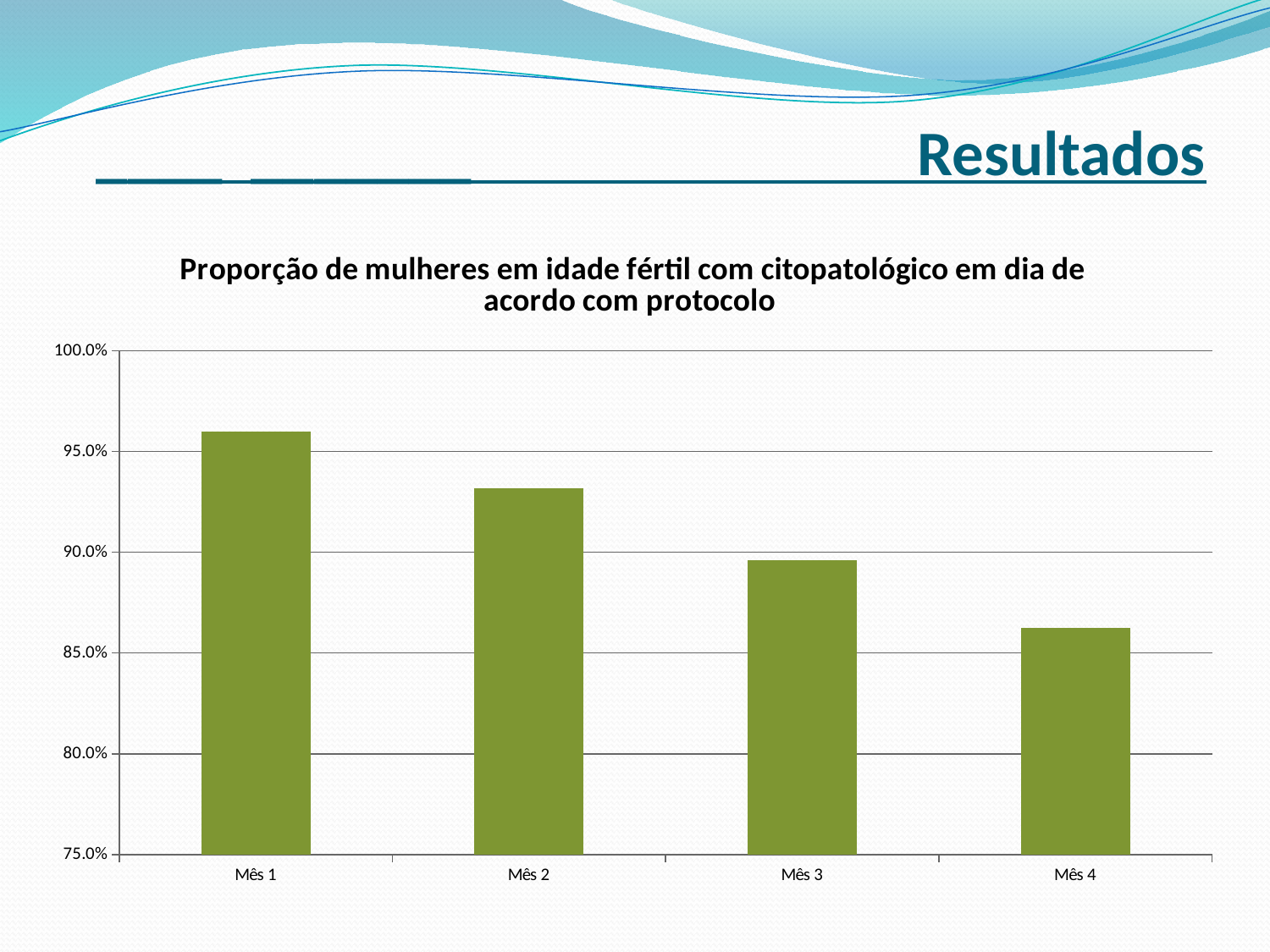
Which month has the highest proportion? Mês 1 Which is larger, the value for Mês 2 or the value for Mês 3? Mês 2 What kind of chart is shown on the slide? bar chart What is the title of the chart? Proporção de mulheres em idade fértil com citopatológico em dia de acordo com protocolo Is the value for Mês 4 greater or less than 90.0%? less Is the value for Mês 1 greater or less than 95.0%? greater Do the values rise or fall from Mês 1 to Mês 4? fall What is the lowest value shown on the y axis? 75.0% Is the value for Mês 3 greater or less than 85.0%? greater Which month has the lowest proportion? Mês 4 How many categories (months) are shown on the x axis? 4